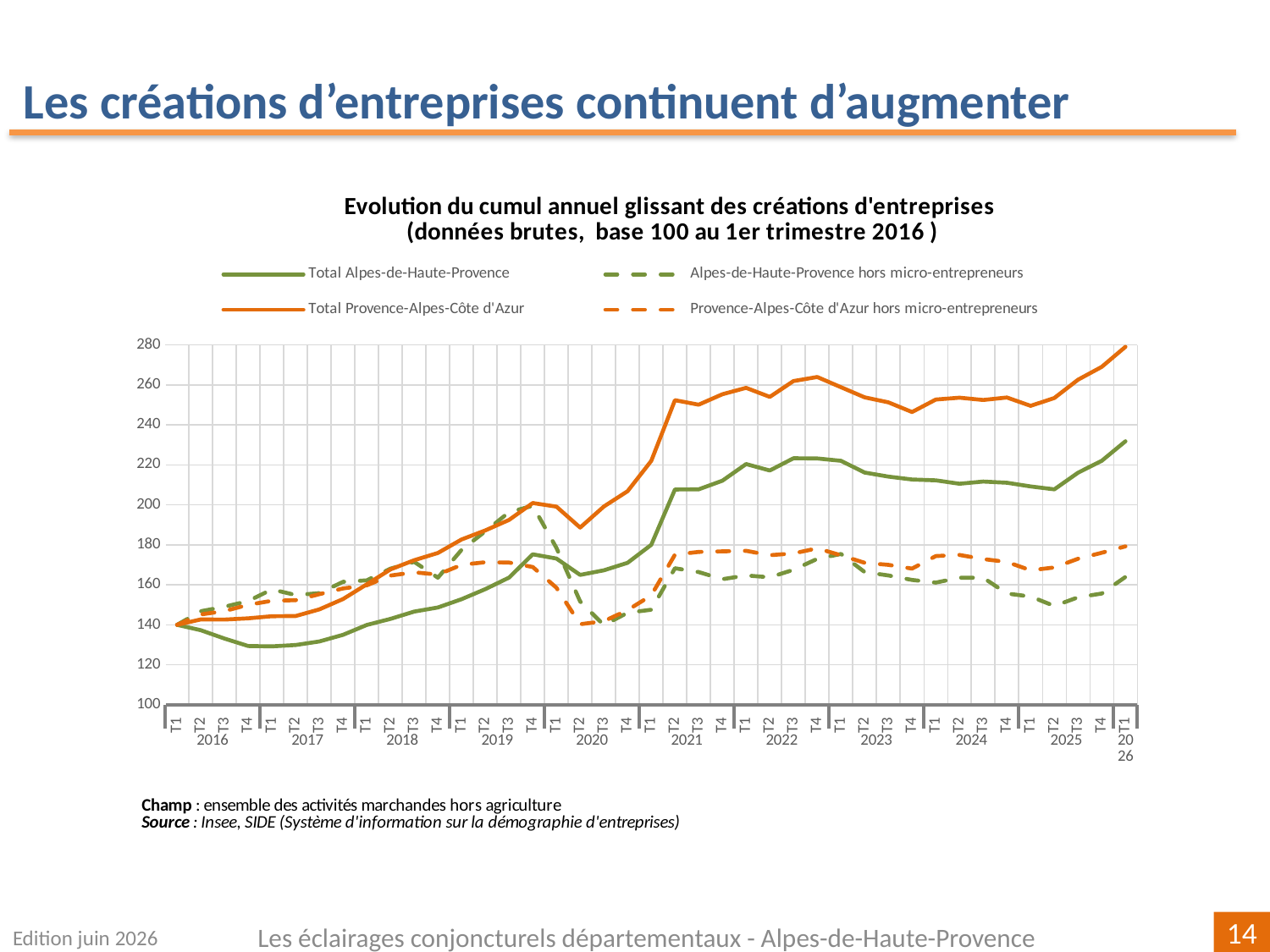
At T1 2026, which is higher: Total Provence-Alpes-Côte d'Azur or Total Alpes-de-Haute-Provence? Total Provence-Alpes-Côte d'Azur Which series has the lowest value at T1 2026? Alpes-de-Haute-Provence hors micro-entrepreneurs Is the value for Total Alpes-de-Haute-Provence at T4 2016 greater or less than 140? less How many series does the legend list? 4 Is the value for Total Alpes-de-Haute-Provence at T1 2026 greater or less than 220? greater Is the value for Total Provence-Alpes-Côte d'Azur at T1 2026 greater or less than 260? greater Which series is drawn as a solid orange line? Total Provence-Alpes-Côte d'Azur What is the title of the chart? Evolution du cumul annuel glissant des créations d'entreprises (données brutes, base 100 au 1er trimestre 2016 ) How many years are labelled on the x axis? 11 What kind of chart is shown on the slide? line chart Does the Total Provence-Alpes-Côte d'Azur series rise or fall overall from T1 2016 to T1 2026? rise